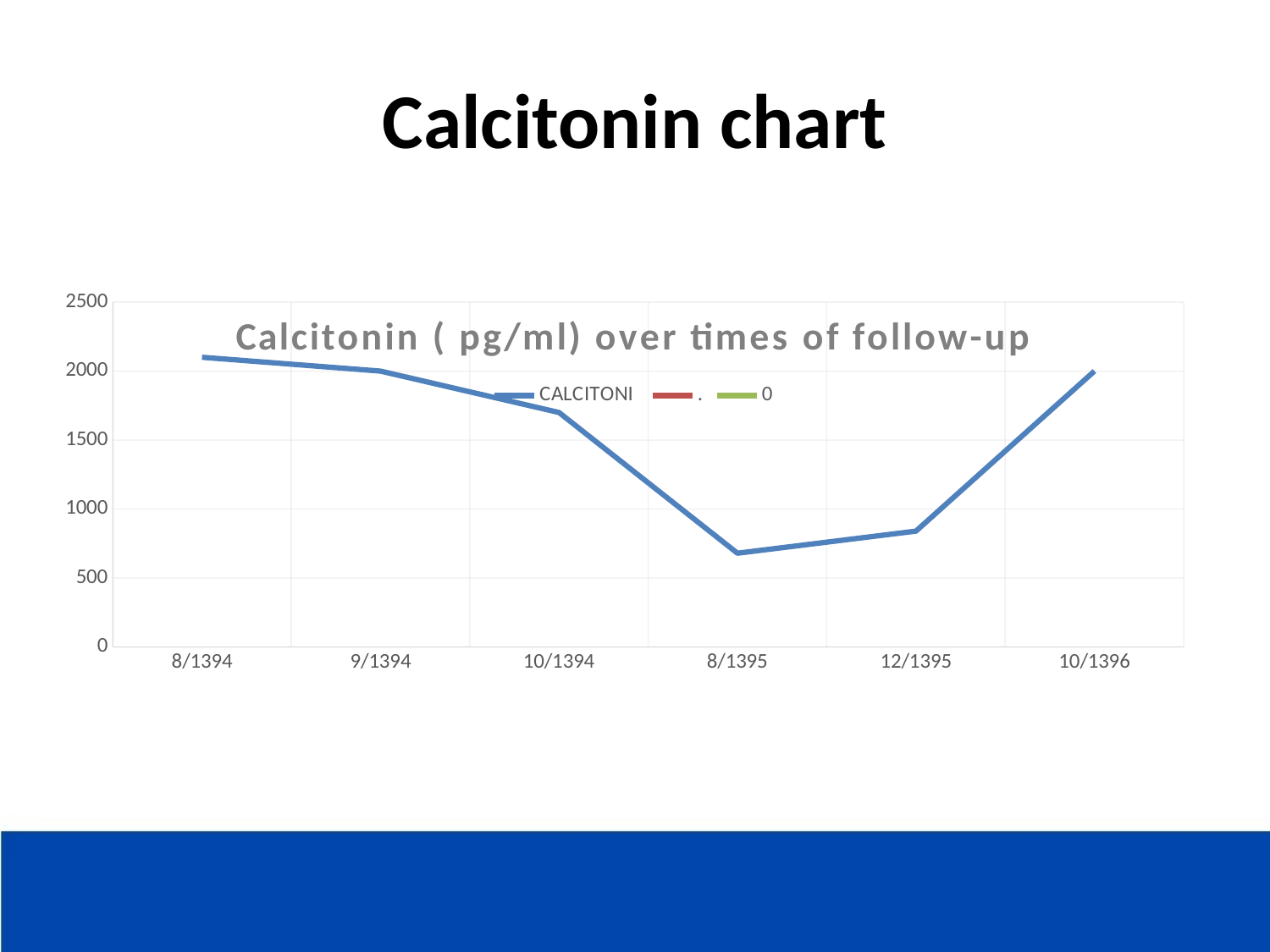
How many time points are plotted along the x axis? 6 How many entries does the chart legend list? 3 Does the calcitonin value rise or fall from 8/1394 to 8/1395? fall At which time point is the calcitonin value lowest? 8/1395 At which time point is the calcitonin value highest? 8/1394 Is the calcitonin value for 12/1395 greater or less than 1000? less Which has the larger calcitonin value, 10/1394 or 8/1395? 10/1394 What kind of chart is shown on the slide? line chart Is the calcitonin value for 8/1394 greater or less than 2000? greater What is the title shown inside the chart area? Calcitonin ( pg/ml) over times of follow-up Is the calcitonin value for 10/1394 greater or less than 1500? greater